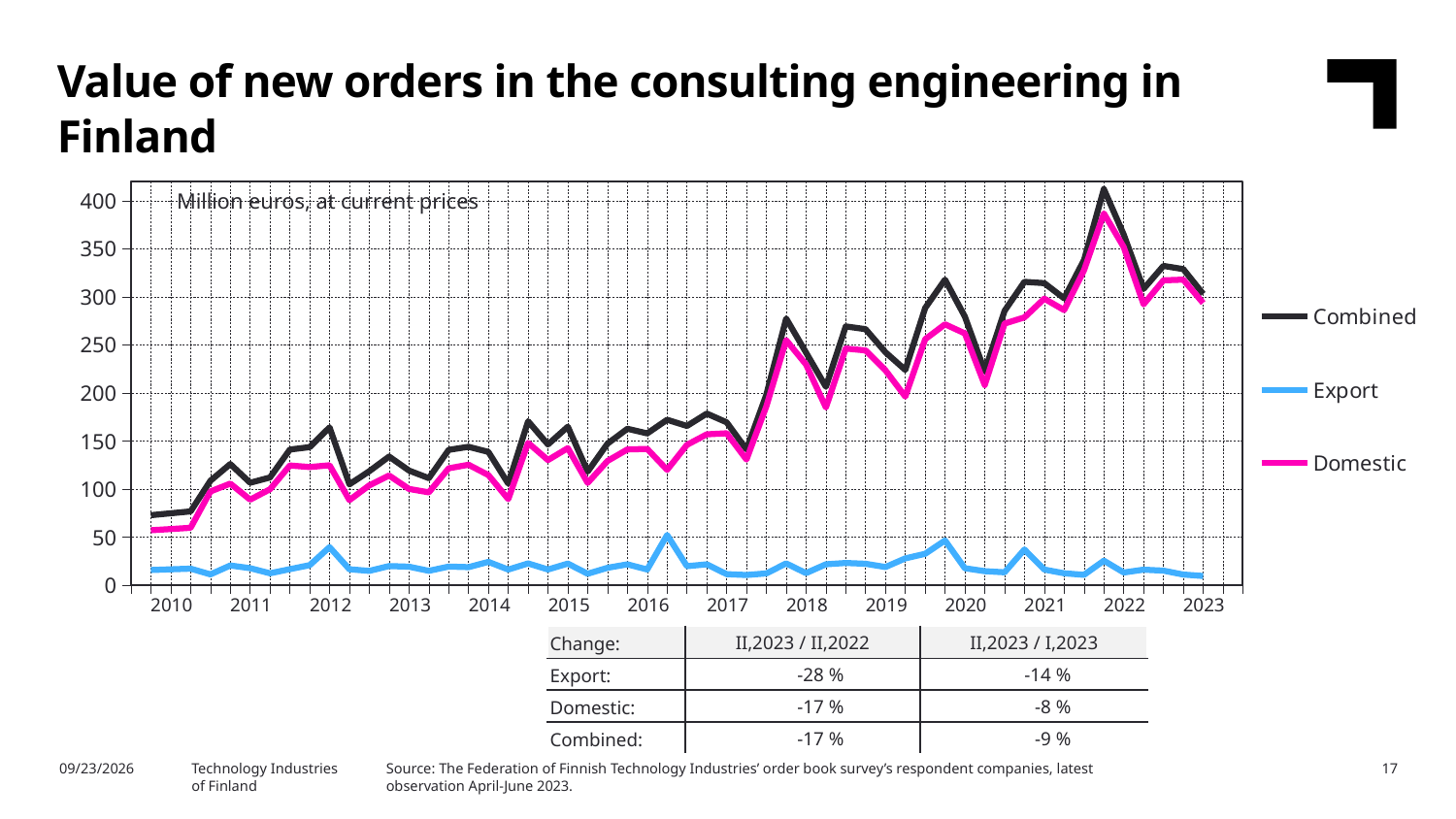
How many series does the legend list? 3 Which series has the lowest values across the whole chart? Export Is the peak value of the Combined series in late 2021 greater or less than 350? greater What unit is stated in the label inside the chart area? Million euros, at current prices Is the Domestic value at the start of 2010 greater or less than 100? less What kind of chart is shown on the slide? Line chart Which is larger in 2023, the Combined series or the Export series? Combined Which series are listed in the chart legend? Combined, Export, Domestic Is the highest value of the Export series greater or less than 100? less Does the Combined series generally rise or fall from 2010 to 2023? Rise Which series has the highest values across the whole chart? Combined